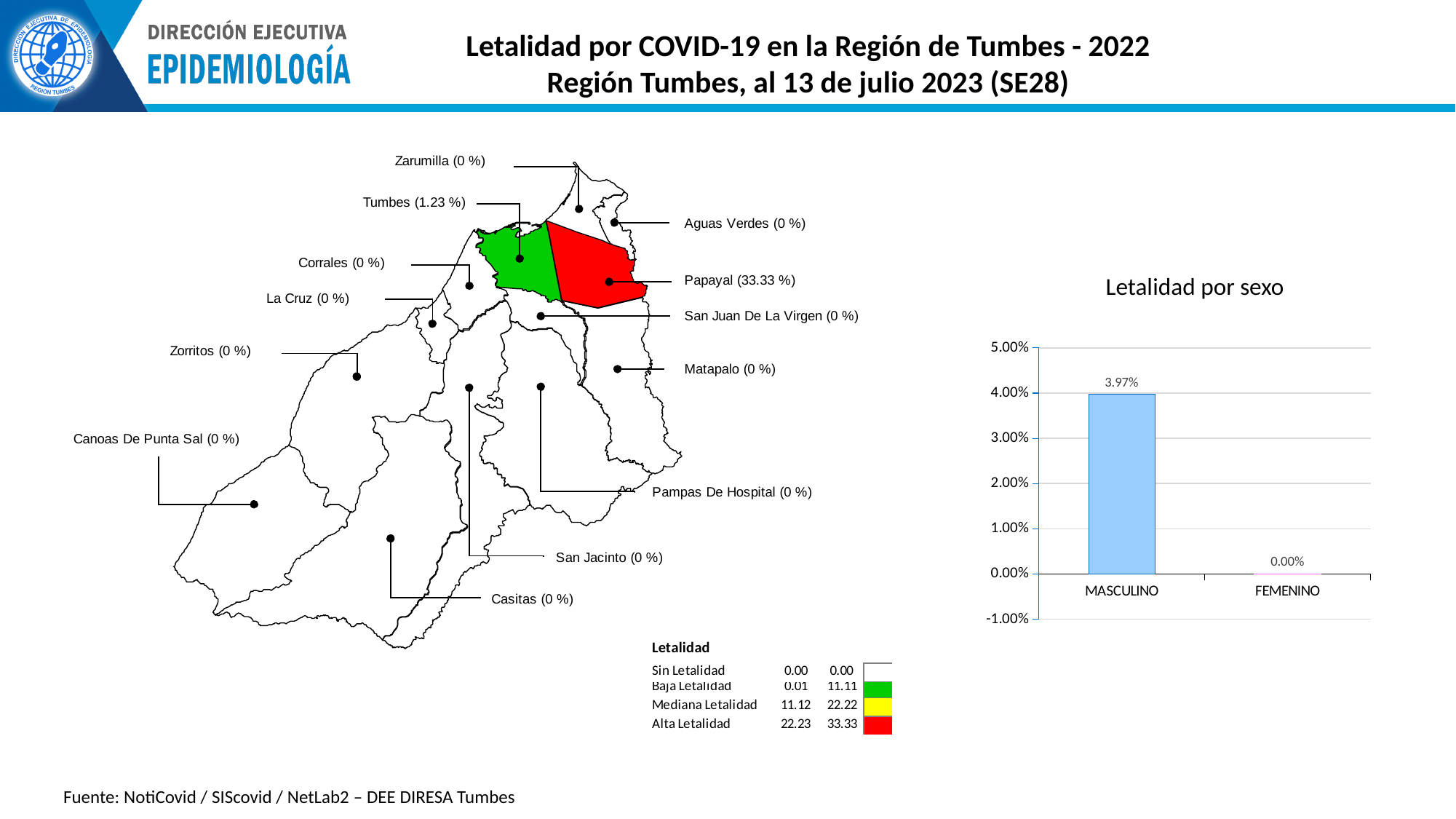
In the 'Letalidad por sexo' chart, what is the value for FEMENINO? 0.00% In the 'Letalidad por sexo' chart, how many categories are shown on the x axis? 2 In the 'Letalidad por sexo' chart, which category has the highest value? MASCULINO In the 'Letalidad por sexo' chart, what is the value for MASCULINO? 3.97% In the 'Letalidad por sexo' chart, is the value for MASCULINO greater or less than 3.00%? greater In the 'Letalidad por sexo' chart, what is the difference between the MASCULINO and FEMENINO values? 3.97% In the 'Letalidad por sexo' chart, which category has the lowest value? FEMENINO What is the title of the chart on the right side of the slide? Letalidad por sexo On the map of the Tumbes region, which district has the highest lethality value? Papayal On the map of the Tumbes region, what colour is the Papayal district shaded? red What kind of chart is 'Letalidad por sexo'? bar chart On the map of the Tumbes region, what is the lethality value shown for Tumbes? 1.23 %